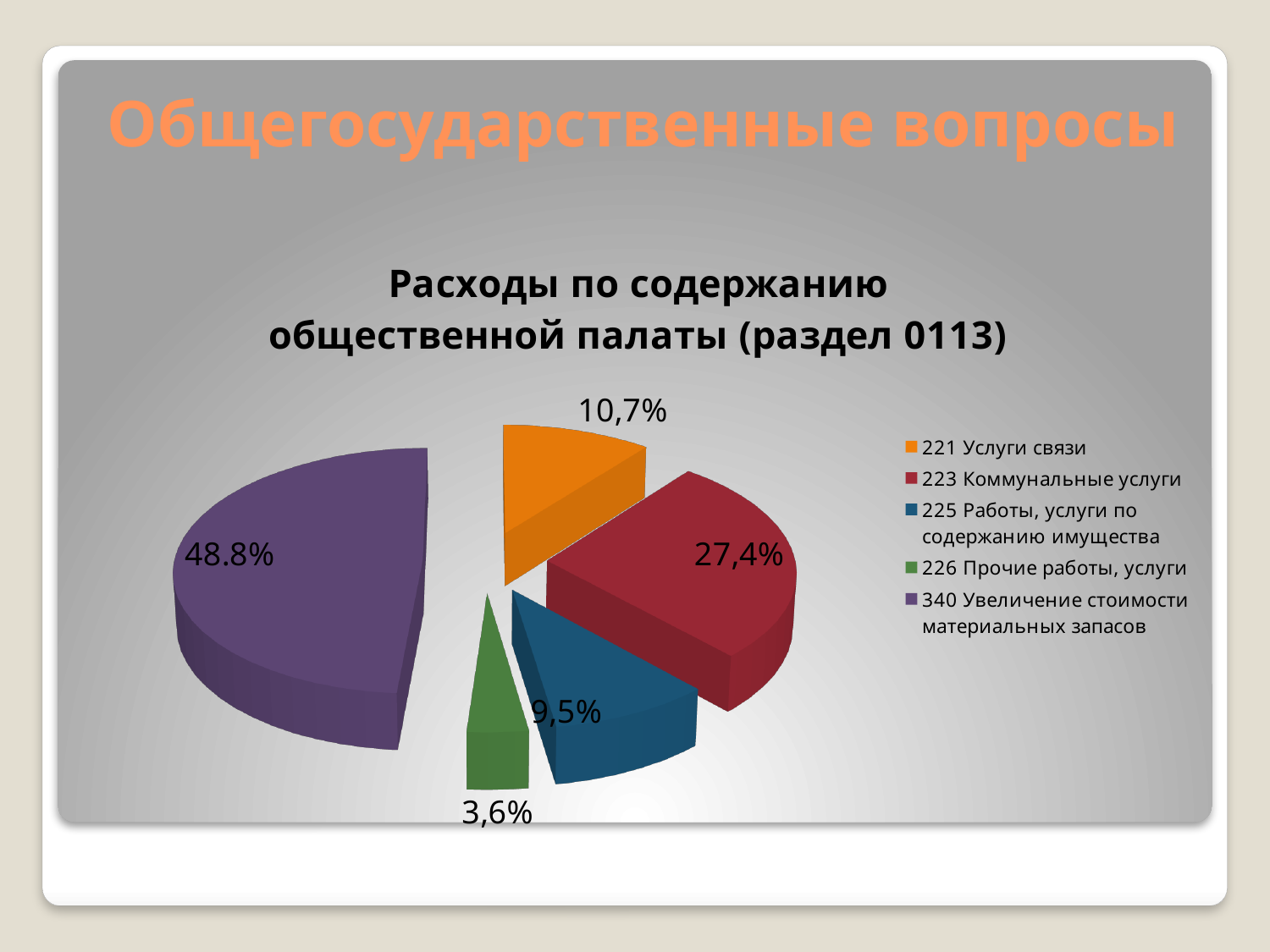
What value is shown for "223 Коммунальные услуги"? 27,4% What value is shown for "226 Прочие работы, услуги"? 3,6% Which category has the largest slice of the pie? 340 Увеличение стоимости материальных запасов What is the difference in percentage points between "223 Коммунальные услуги" and "221 Услуги связи"? 16,7 What type of chart is shown on the slide? Pie chart What share of the pie does "221 Услуги связи" have? 10,7% What value is shown for "225 Работы, услуги по содержанию имущества"? 9,5% What is the title of the chart? Расходы по содержанию общественной палаты (раздел 0113) How many categories does the legend list? 5 What share of the pie does "340 Увеличение стоимости материальных запасов" have? 48.8% Which is larger: the slice for "221 Услуги связи" or the slice for "225 Работы, услуги по содержанию имущества"? 221 Услуги связи Which category has the smallest slice of the pie? 226 Прочие работы, услуги